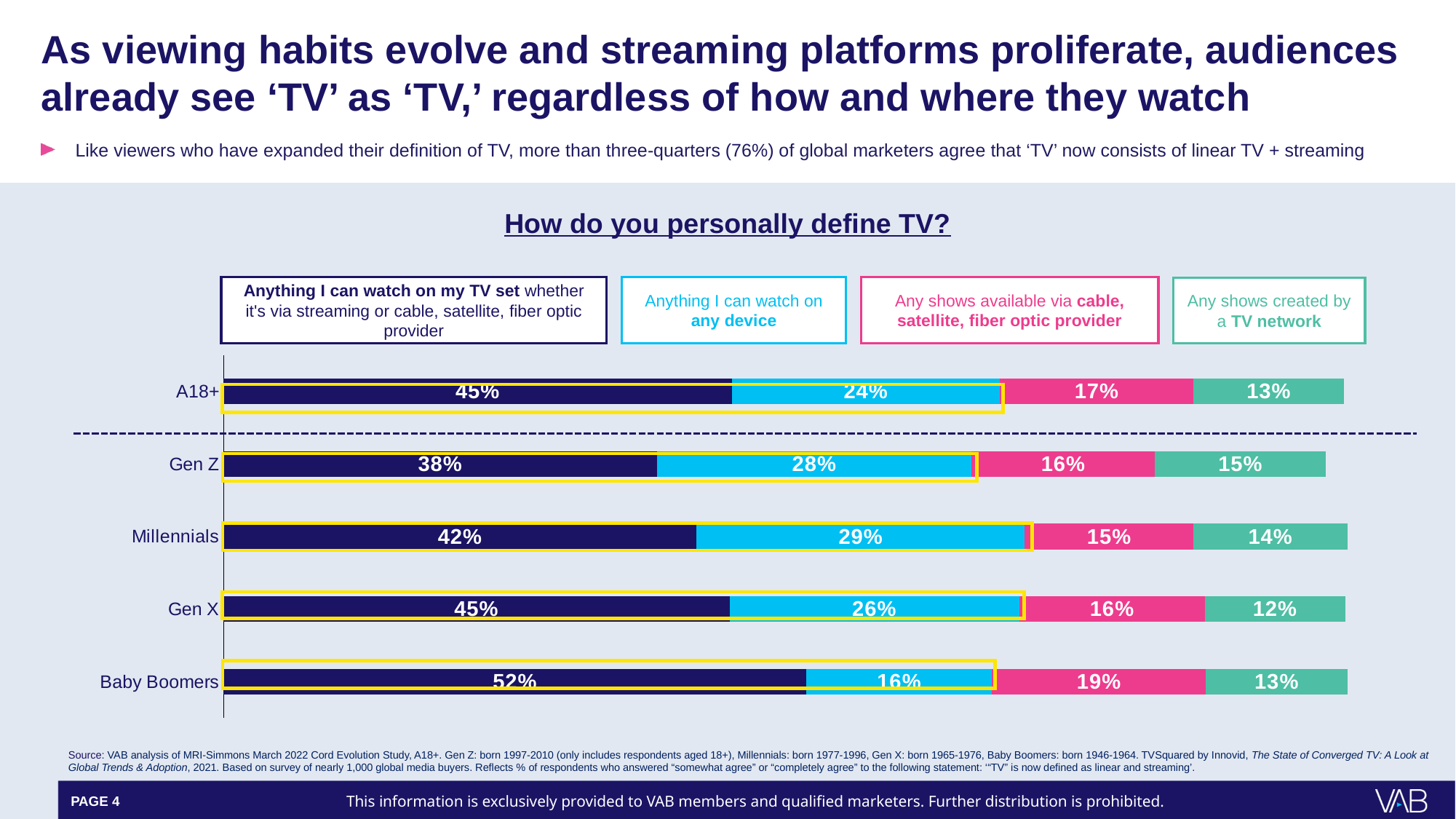
How many audience groups are shown in the chart? 5 What percentage of Baby Boomers define TV as 'Anything I can watch on my TV set'? 52% What is the difference between Gen Z and Baby Boomers for 'Anything I can watch on any device'? 12 percentage points How many response categories (series) does the chart legend list? 4 Which group has a larger share for 'Anything I can watch on my TV set', Gen X or Millennials? Gen X What percentage of Gen Z define TV as 'Anything I can watch on any device'? 28% What percentage of A18+ define TV as 'Any shows available via cable, satellite, fiber optic provider'? 17% What percentage of Millennials define TV as 'Any shows created by a TV network'? 14% What type of chart is used on the slide? Stacked bar chart Which group has the highest share defining TV as 'Anything I can watch on my TV set'? Baby Boomers What is the total of the stacked bar for Millennials? 100% Which group has the lowest share defining TV as 'Anything I can watch on any device'? Baby Boomers